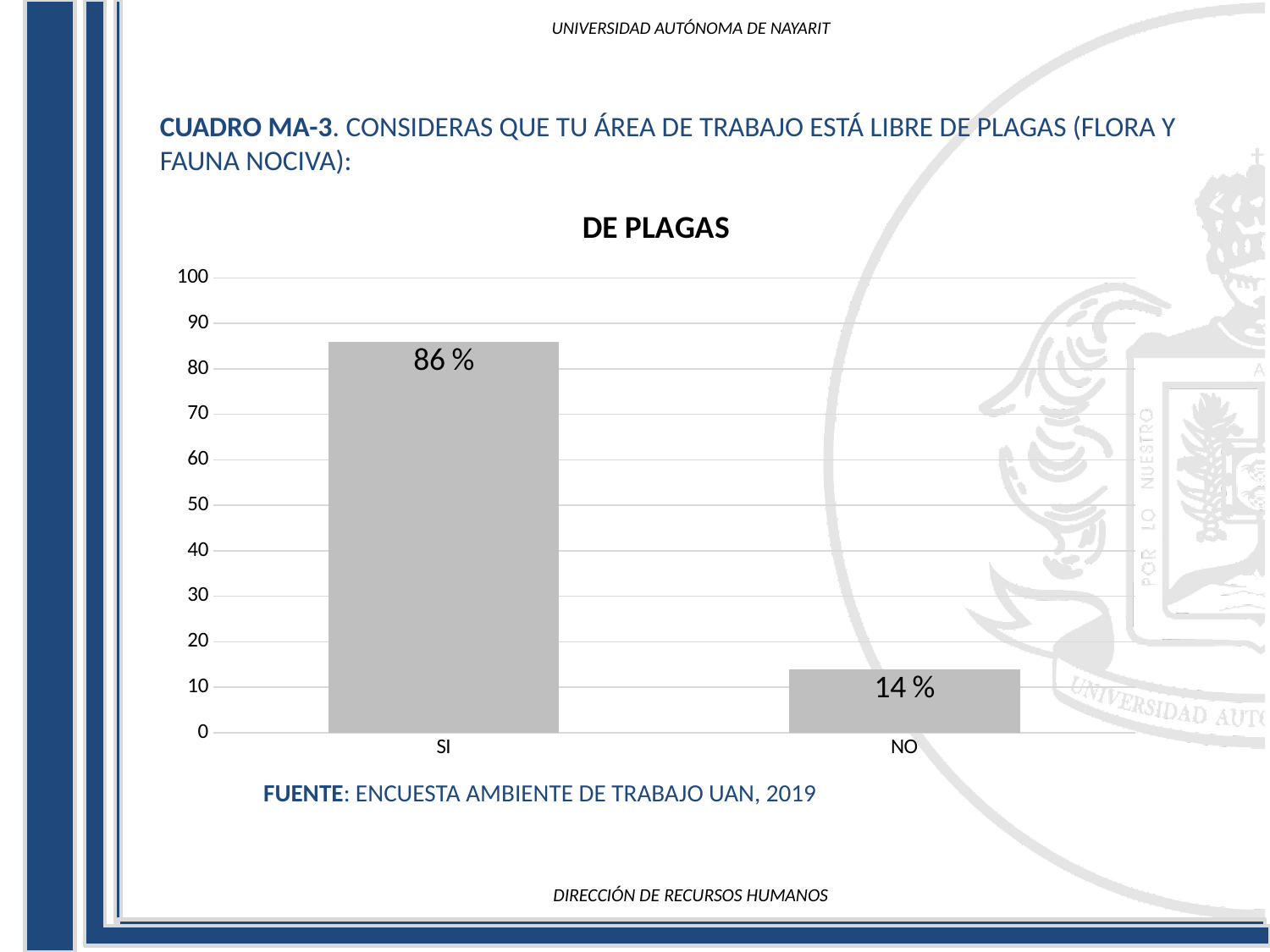
Is the value for NO greater or less than 20? less Is the value for SI greater or less than 80? greater What kind of chart is shown on the slide? bar chart Which is larger, the value for SI or the value for NO? SI What is the value for NO? 14 % Which category has the lowest value? NO What is the highest value shown on the y axis? 100 What is the title of the chart? DE PLAGAS What is the value for SI? 86 % What is the difference between the values for SI and NO? 72 % Which category has the highest value? SI How many categories are shown on the x axis? 2